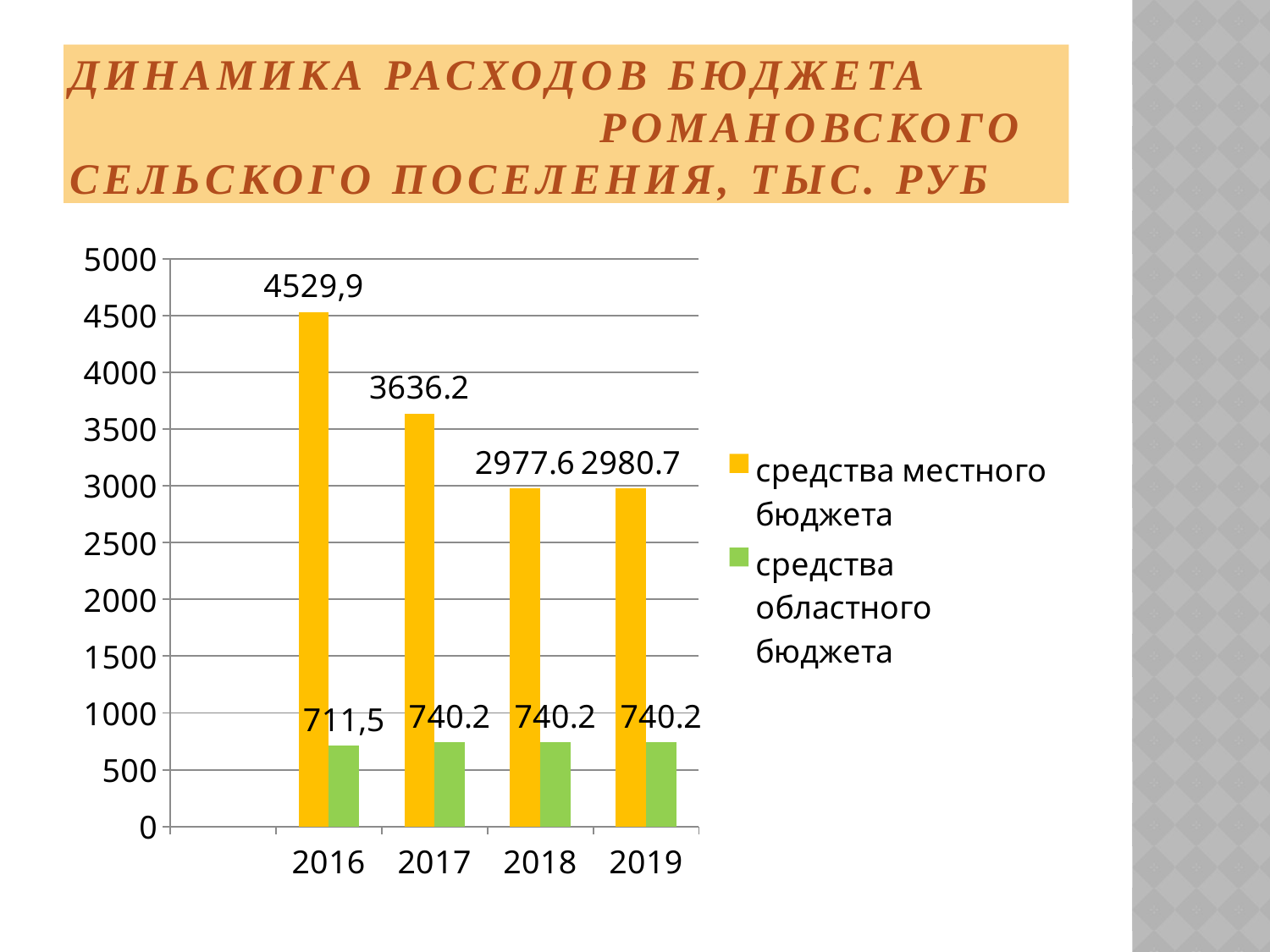
How many series does the legend list? 2 In which year is средства местного бюджета the lowest? 2018 What is the value for средства местного бюджета in 2016? 4529,9 What is the value for средства местного бюджета in 2017? 3636.2 In which year is средства местного бюджета the highest? 2016 What is the difference between средства местного бюджета in 2017 and in 2018? 658.6 How many years are shown on the x axis? 4 What is the value for средства областного бюджета in 2019? 740.2 What is the difference between средства областного бюджета in 2017 and in 2016? 28.7 What kind of chart is shown on the slide? bar chart What is the value for средства областного бюджета in 2016? 711,5 Which year has the larger value for средства местного бюджета, 2018 or 2019? 2019